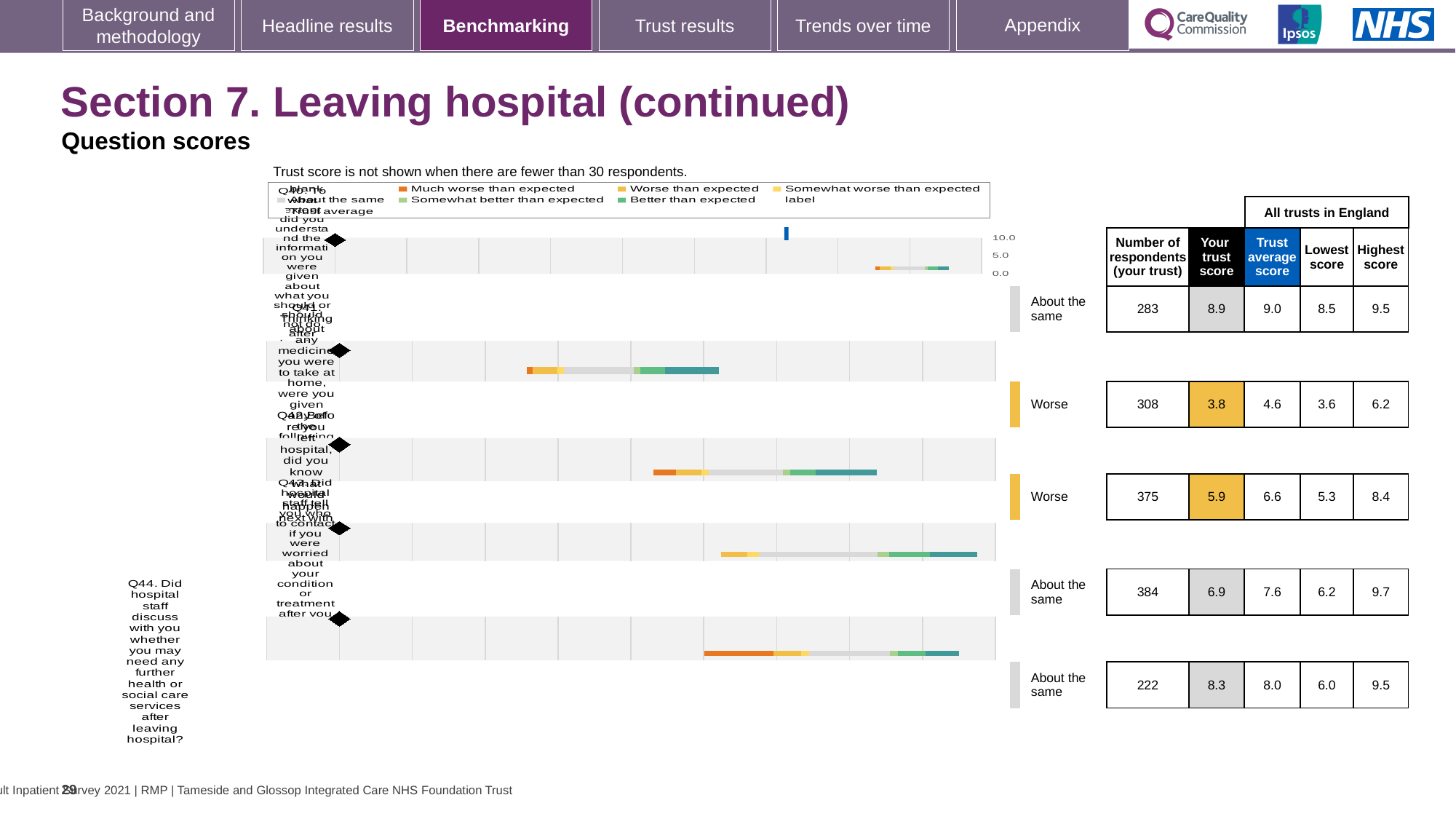
How many respondents answered Q44 at this trust? 222 What is the trust average score for Q44? 8.0 How many of the question rows are rated 'Worse'? 2 What benchmark category is shown for Q44? About the same How many question rows are shown in the benchmarking chart on this slide? 5 What is the highest 'Your trust score' shown in the table on this slide? 8.9 For the question with 308 respondents, is the trust score higher or lower than the trust average score? lower What is the lowest 'Your trust score' shown in the table on this slide? 3.8 What is the 'Your trust score' for Q44 (Did hospital staff discuss with you whether you may need any further health or social care services after leaving hospital?)? 8.3 What is the highest score across all trusts in England for Q44? 9.5 By how much does the trust score for Q44 exceed the trust average score for Q44? 0.3 What is the lowest score across all trusts in England for Q44? 6.0